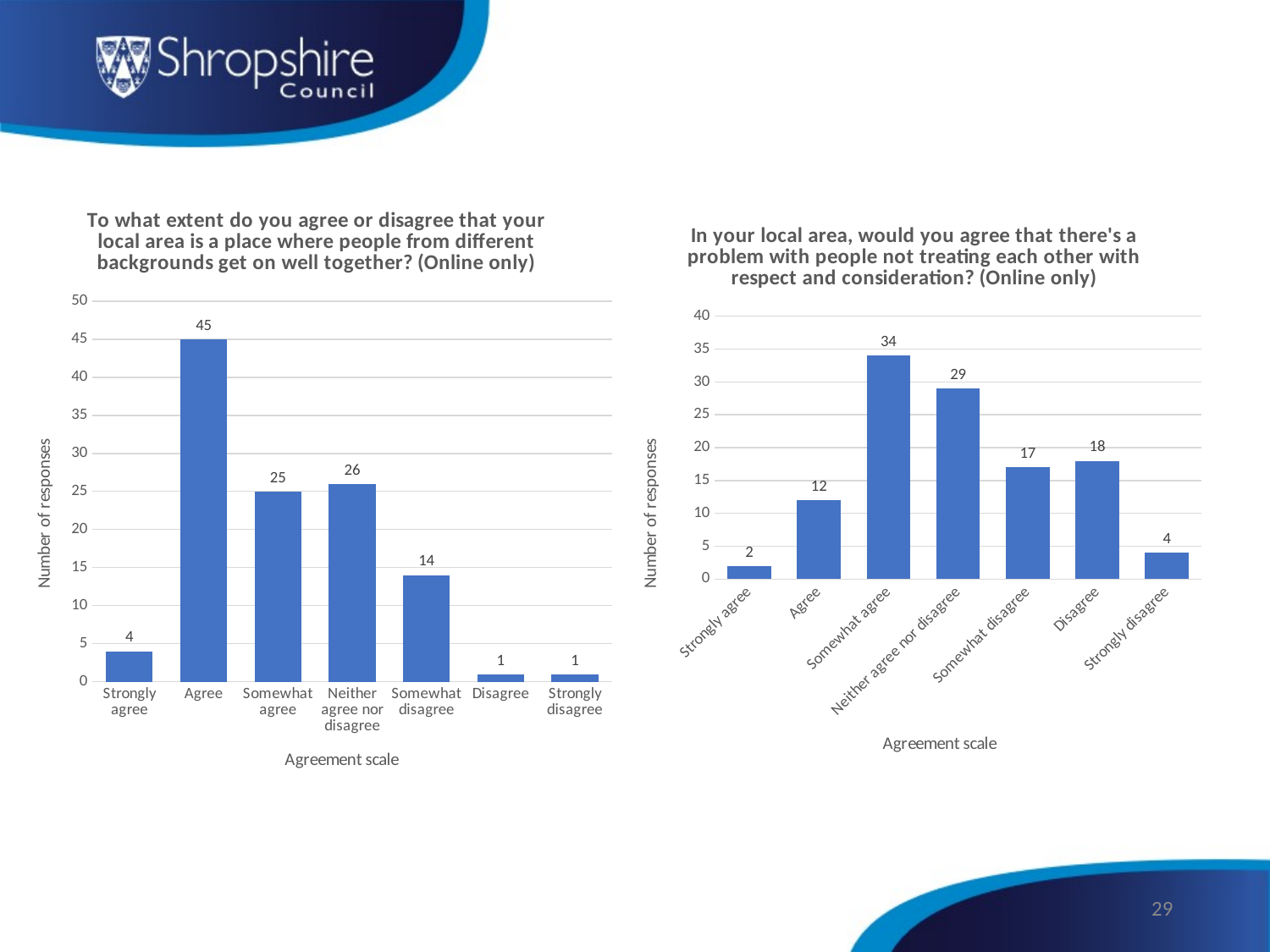
What is the y-axis label of the left chart (people from different backgrounds get on well together)? Number of responses In the left chart (people from different backgrounds get on well together), how many categories are shown on the x axis? 7 In the right chart (problem with people not treating each other with respect), which category has the lowest number of responses? Strongly agree In the right chart (problem with people not treating each other with respect), which category has the highest number of responses? Somewhat agree In the right chart (problem with people not treating each other with respect), how many responses were 'Neither agree nor disagree'? 29 What type of chart is the right chart (problem with people not treating each other with respect)? Bar chart In the left chart (people from different backgrounds get on well together), what is the difference between 'Somewhat agree' and 'Somewhat disagree'? 11 In the right chart (problem with people not treating each other with respect), what is the difference between 'Disagree' and 'Somewhat disagree'? 1 In the left chart (people from different backgrounds get on well together), which is larger: 'Somewhat agree' or 'Neither agree nor disagree'? Neither agree nor disagree In the left chart (people from different backgrounds get on well together), how many responses were 'Agree'? 45 In the left chart (people from different backgrounds get on well together), which category has the highest number of responses? Agree In the right chart (problem with people not treating each other with respect), is the value for 'Somewhat agree' greater or less than 30? greater